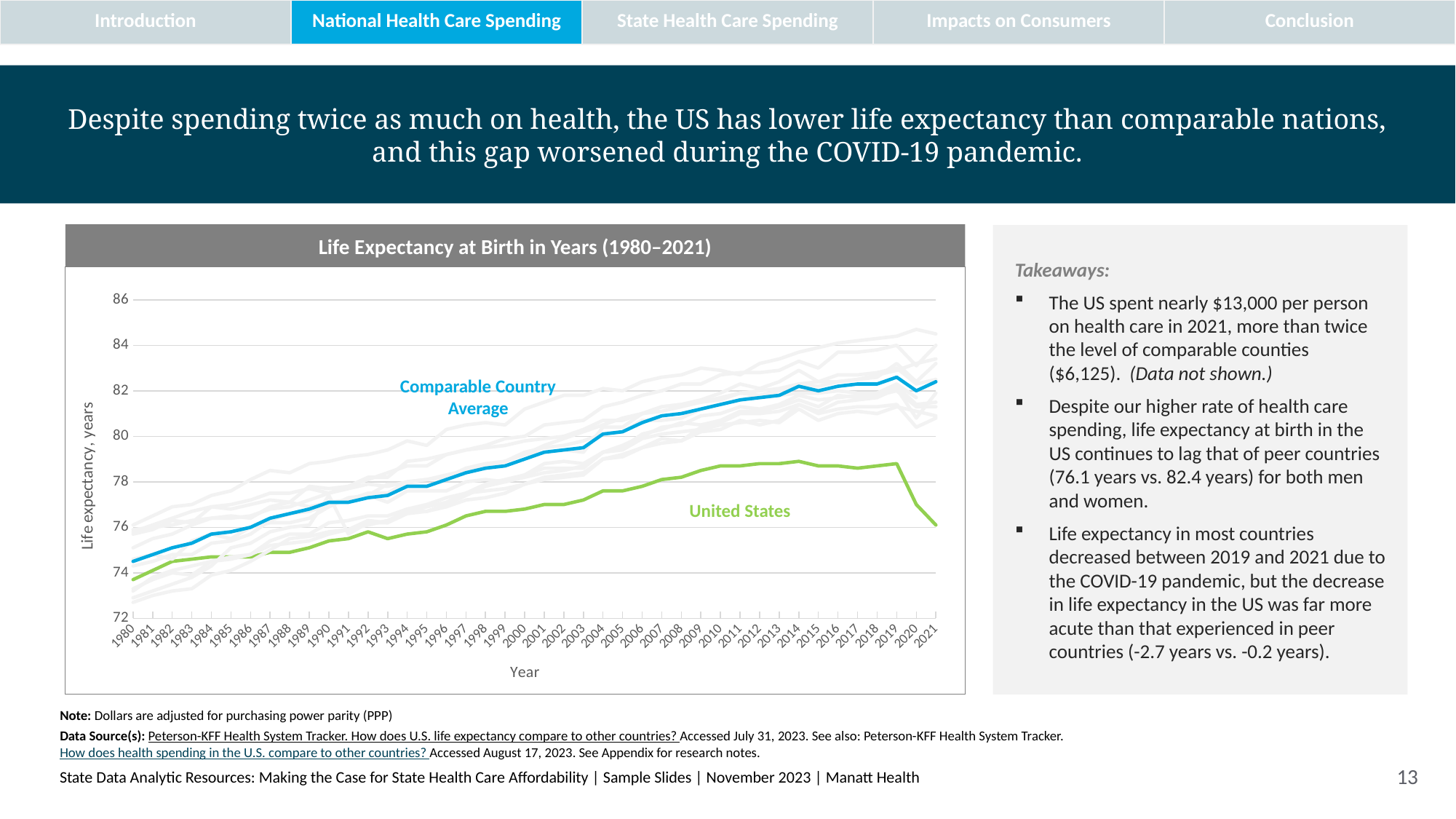
What kind of chart is shown on the slide? Line chart What is the title of the chart? Life Expectancy at Birth in Years (1980–2021) Does the United States line rise or fall between 2019 and 2021? fall Is the value for the United States in 1980 greater or less than 74? less Is the value for the United States in 2019 greater or less than 78? greater What is the label on the y axis of the chart? Life expectancy, years How many years are shown on the x axis of the chart? 42 Is the value for the Comparable Country Average in 1980 greater or less than 76? less Which of the two labelled lines is higher in 2021, United States or Comparable Country Average? Comparable Country Average Does the Comparable Country Average line generally rise or fall from 1980 to 2019? rise